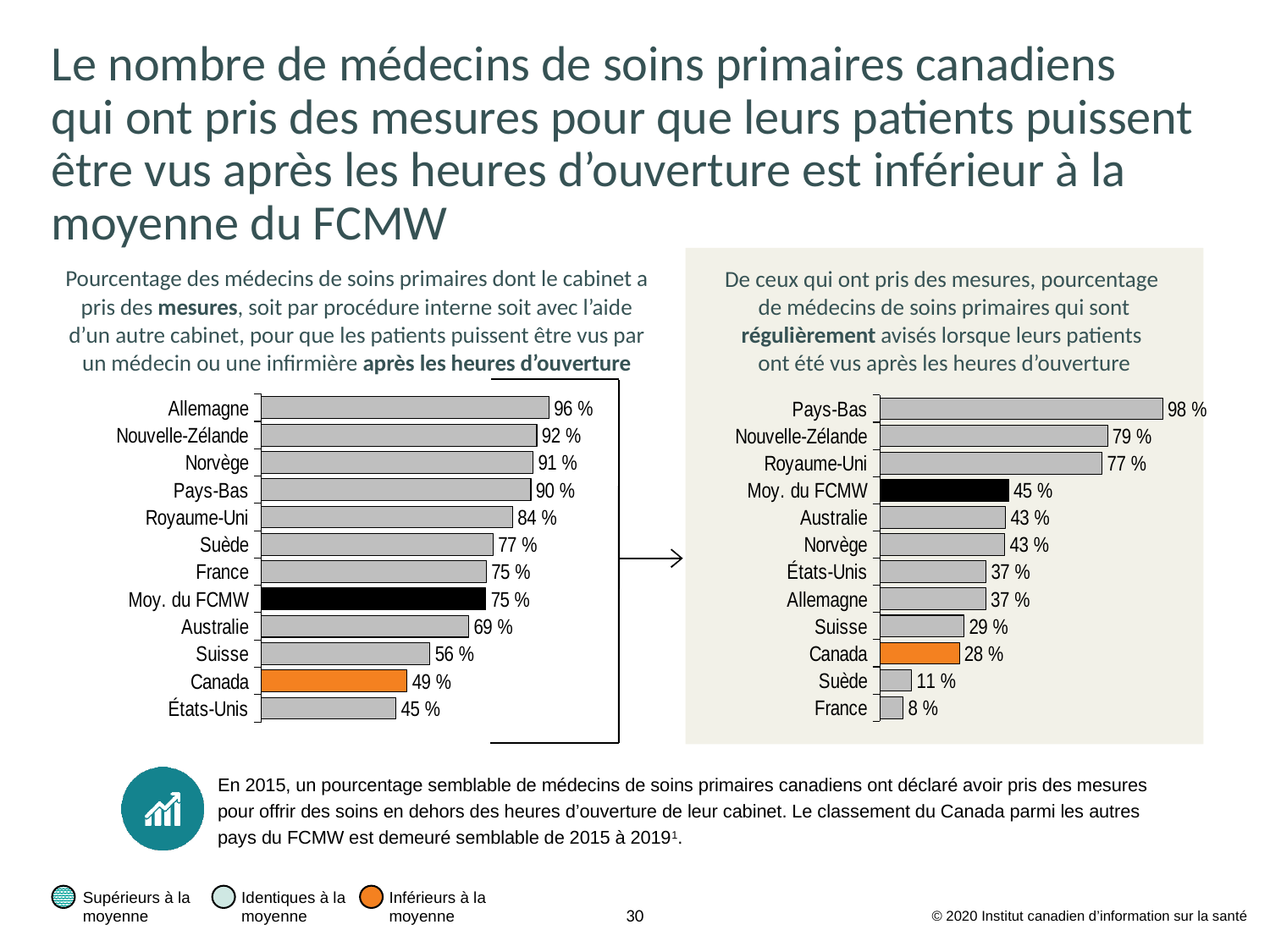
In the right chart, which country has the lowest value? France In the left chart, how many bars are plotted? 12 What type of chart is the left chart? Bar chart In the left chart, what is the value for Canada? 49 % In the left chart, which country has the lowest value? États-Unis In the right chart, which is larger, the value for Suisse or the value for Canada? Suisse In the right chart, what is the value for Moy. du FCMW? 45 % In the left chart, what is the difference between the value for Moy. du FCMW and the value for Canada? 26 % In the left chart, which country has the highest value? Allemagne In the right chart, what is the value for Pays-Bas? 98 % In the right chart, which bar is coloured orange? Canada In the right chart, what is the difference between the value for Nouvelle-Zélande and the value for Royaume-Uni? 2 %